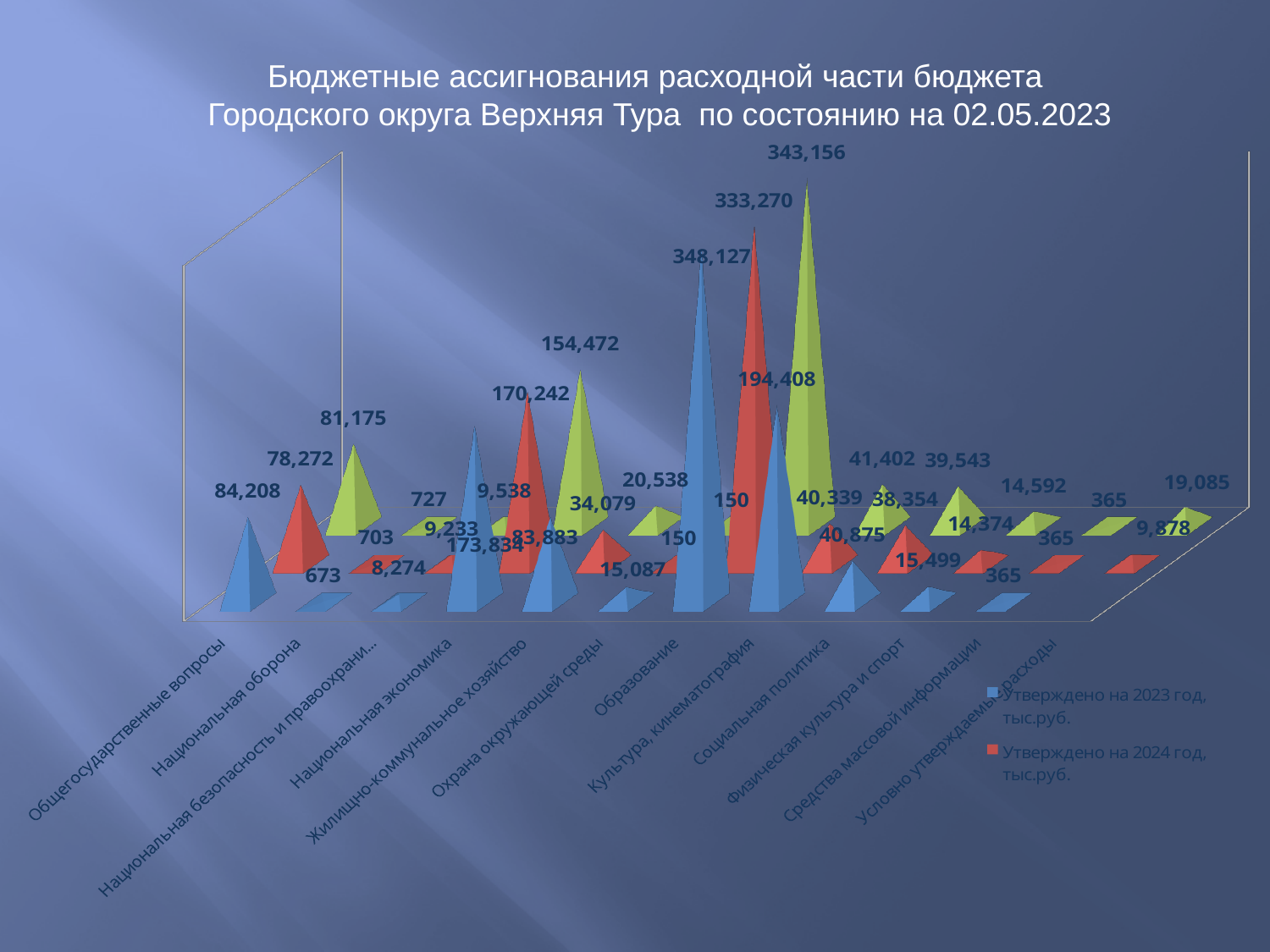
What is the value for Общегосударственные вопросы in the series 'Утверждено на 2023 год, тыс.руб.'? 84,208 What is the value for Образование in the series 'Утверждено на 2024 год, тыс.руб.'? 333,270 What is the value for Образование in the series 'Утверждено на 2023 год, тыс.руб.'? 348,127 What is the difference between the 2023 and 2024 values for Образование? 14,857 What colour represents the series 'Утверждено на 2023 год, тыс.руб.' in the legend? Blue How many categories are shown on the x axis of the chart? 12 What is the difference between the 2023 and 2024 values for Общегосударственные вопросы? 5,936 For Национальная экономика, which is larger: the value for 2023 or the value for 2024? 2023 What is the value for Национальная оборона in the series 'Утверждено на 2024 год, тыс.руб.'? 703 Which category has the highest value in the series 'Утверждено на 2023 год, тыс.руб.'? Образование What kind of chart is shown on the slide? Bar chart What is the value for Национальная экономика in the series 'Утверждено на 2023 год, тыс.руб.'? 173,834